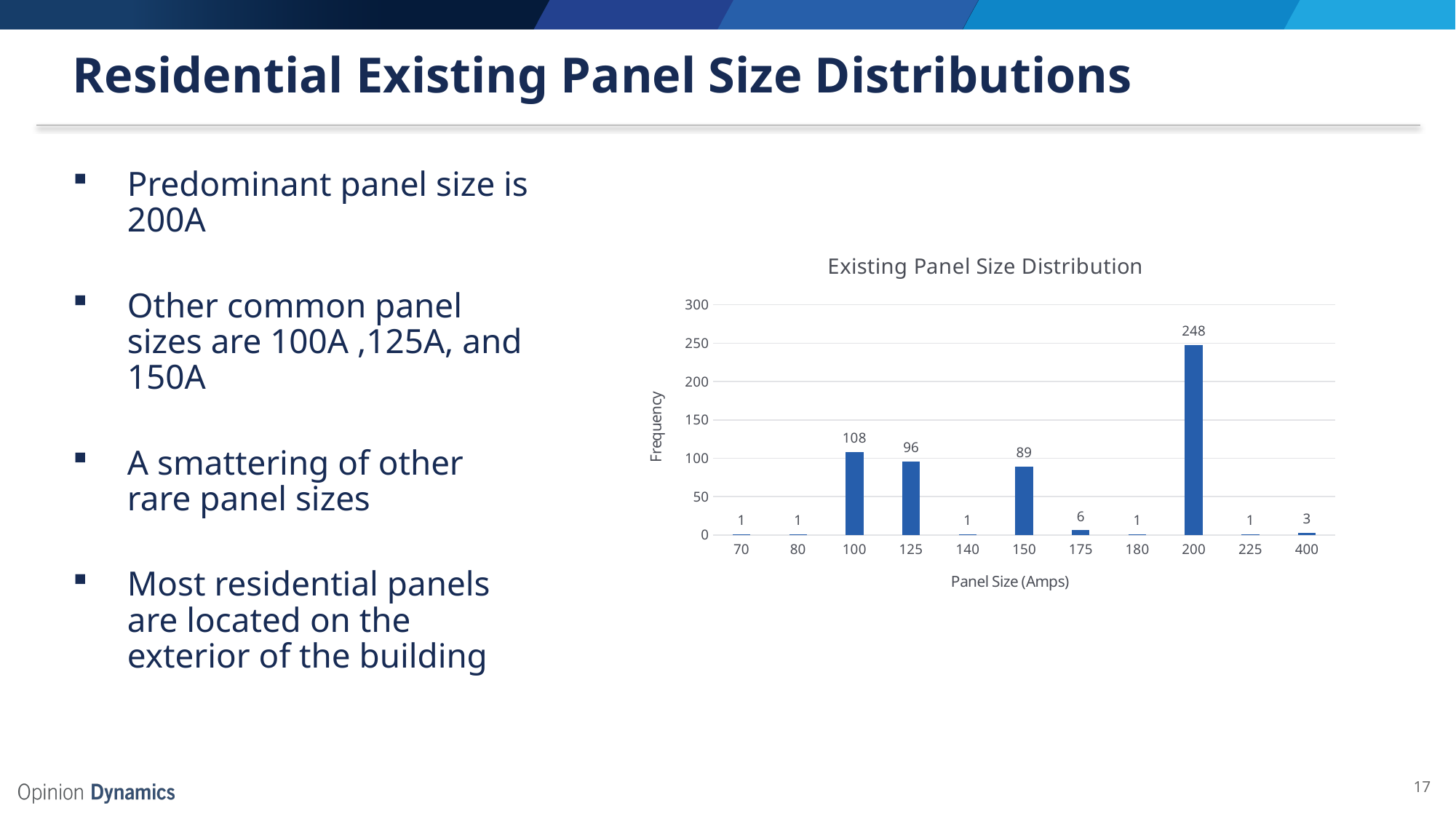
What type of chart is shown on the slide? bar chart How many panel size categories are shown on the x axis? 11 What is the frequency for the 200 amp panel size? 248 What is the frequency for the 175 amp panel size? 6 What is the frequency for the 150 amp panel size? 89 Is the frequency for the 200 amp panel size greater or less than 200? greater Which panel size has the highest frequency? 200 What is the difference in frequency between the 200 amp and 100 amp panel sizes? 140 What is the difference in frequency between the 100 amp and 125 amp panel sizes? 12 What is the frequency for the 100 amp panel size? 108 Which has a higher frequency, the 125 amp or the 150 amp panel size? 125 What is the title of the chart? Existing Panel Size Distribution